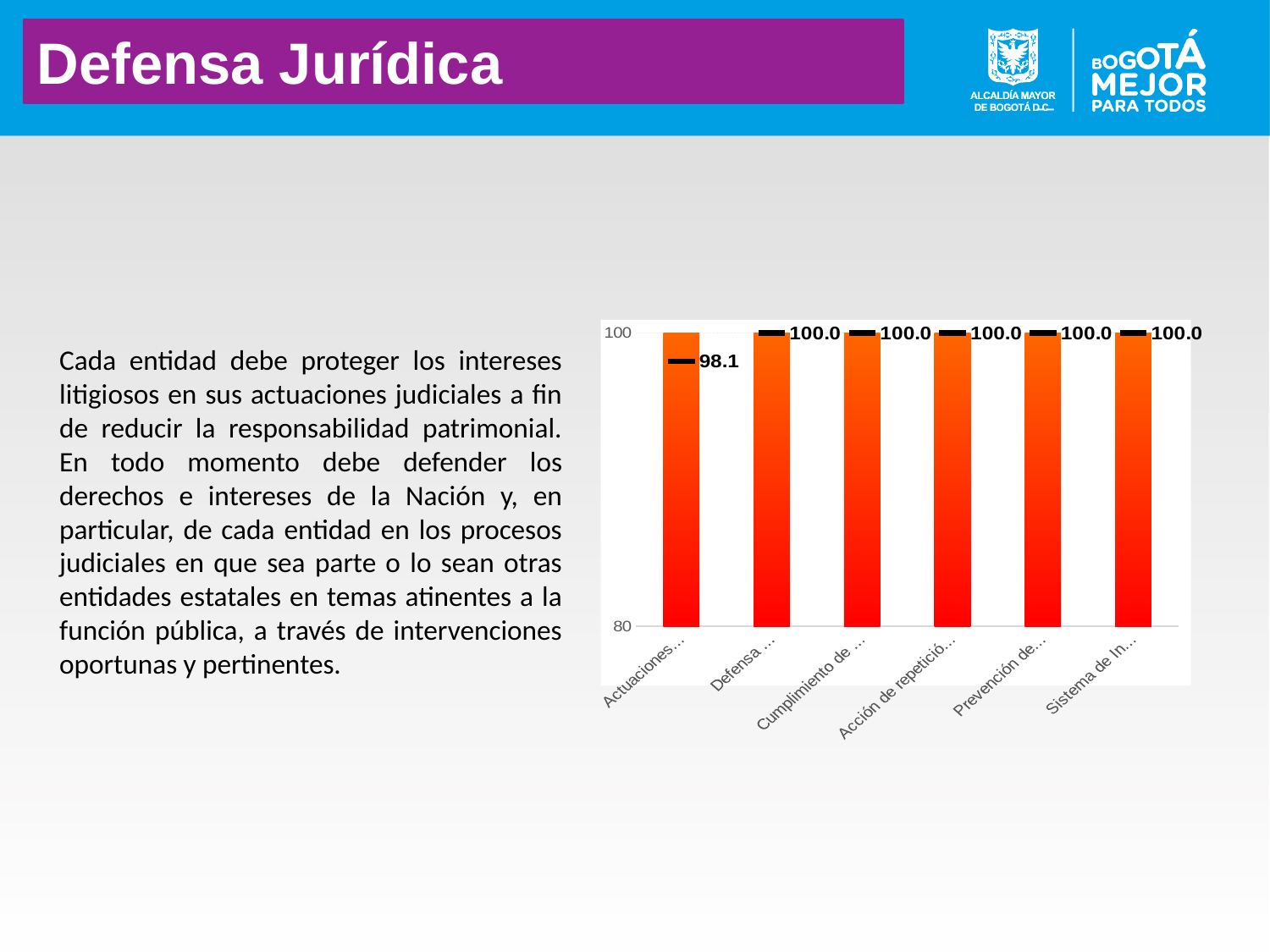
What kind of chart is shown on the slide? Bar chart What is the value of the second bar in the chart? 100.0 What is the value of the last (rightmost) bar in the chart? 100.0 What colour are the bars in the chart? Red/orange How many bars are plotted in the chart? 6 Is the value of the first bar greater or less than 80? greater